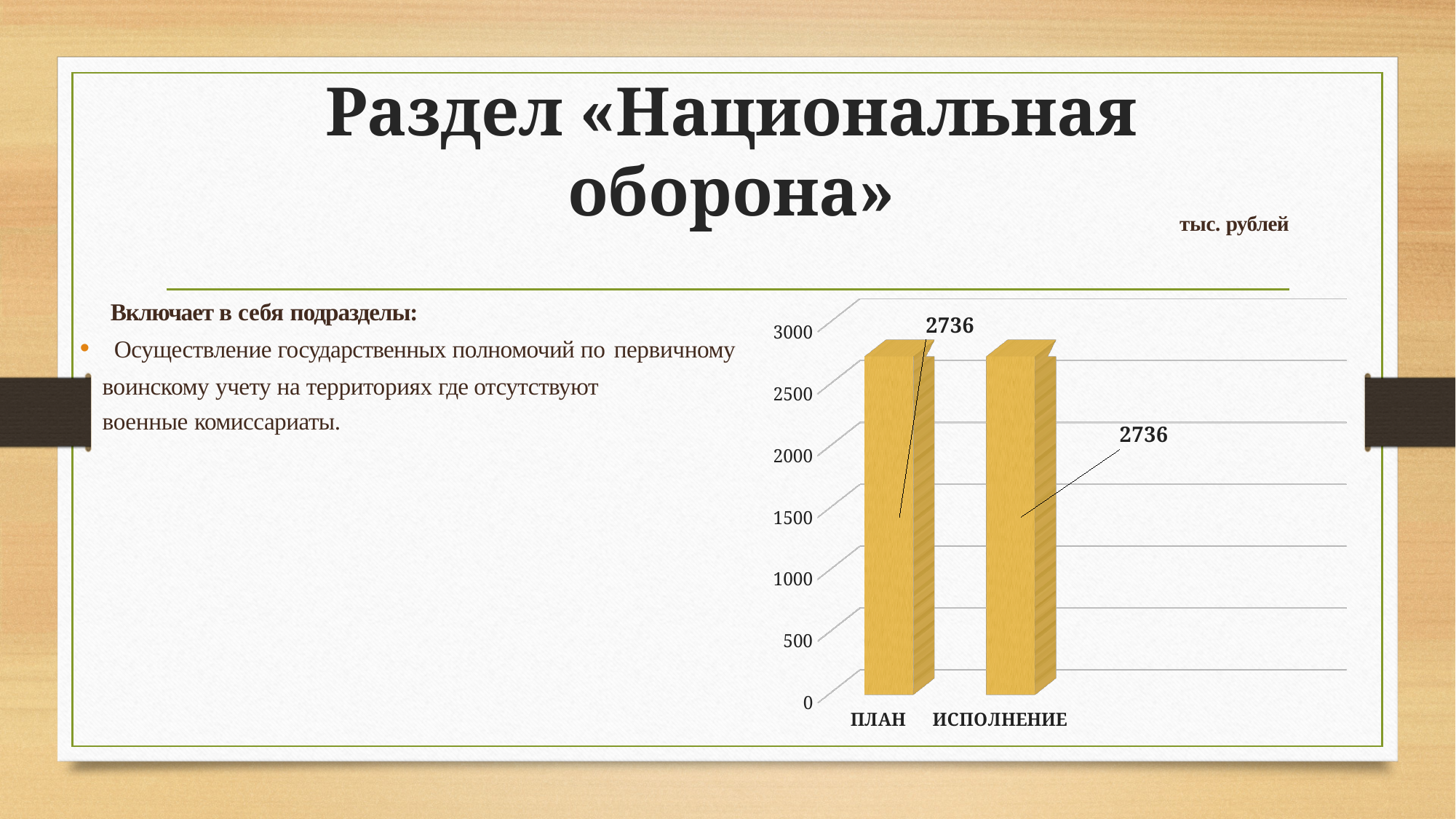
Is the value for ИСПОЛНЕНИЕ greater or less than 3000? less Is the value for ПЛАН greater or less than 2500? greater How many bars are plotted in the chart? 2 What is the total of the values for ПЛАН and ИСПОЛНЕНИЕ? 5472 What is the difference between the values for ПЛАН and ИСПОЛНЕНИЕ? 0 What is the highest tick value shown on the vertical axis? 3000 What is the value for ПЛАН? 2736 What kind of chart is shown on the slide? bar chart What is the value for ИСПОЛНЕНИЕ? 2736 What unit is indicated for the chart values? тыс. рублей